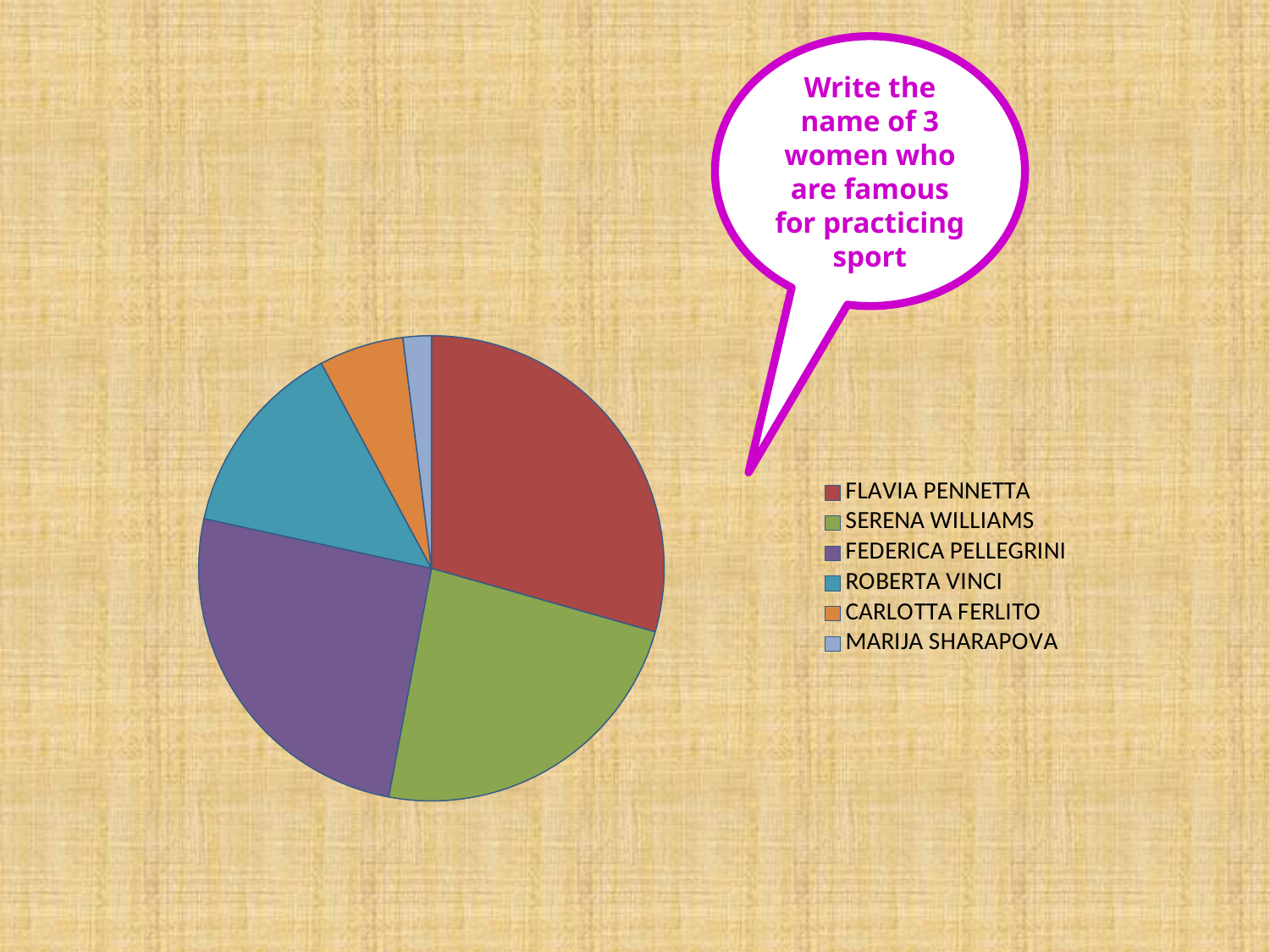
What kind of chart is shown on the slide? pie chart Which slice is larger, SERENA WILLIAMS or CARLOTTA FERLITO? SERENA WILLIAMS Which slice is larger, ROBERTA VINCI or CARLOTTA FERLITO? ROBERTA VINCI What colour is the slice for FLAVIA PENNETTA in the pie chart? red How many entries does the legend of the pie chart list? 6 Which category has the largest slice of the pie chart? FLAVIA PENNETTA Which category is listed first in the legend of the pie chart? FLAVIA PENNETTA Which slice is larger, FLAVIA PENNETTA or ROBERTA VINCI? FLAVIA PENNETTA Which category has the smallest slice of the pie chart? MARIJA SHARAPOVA How many slices does the pie chart have? 6